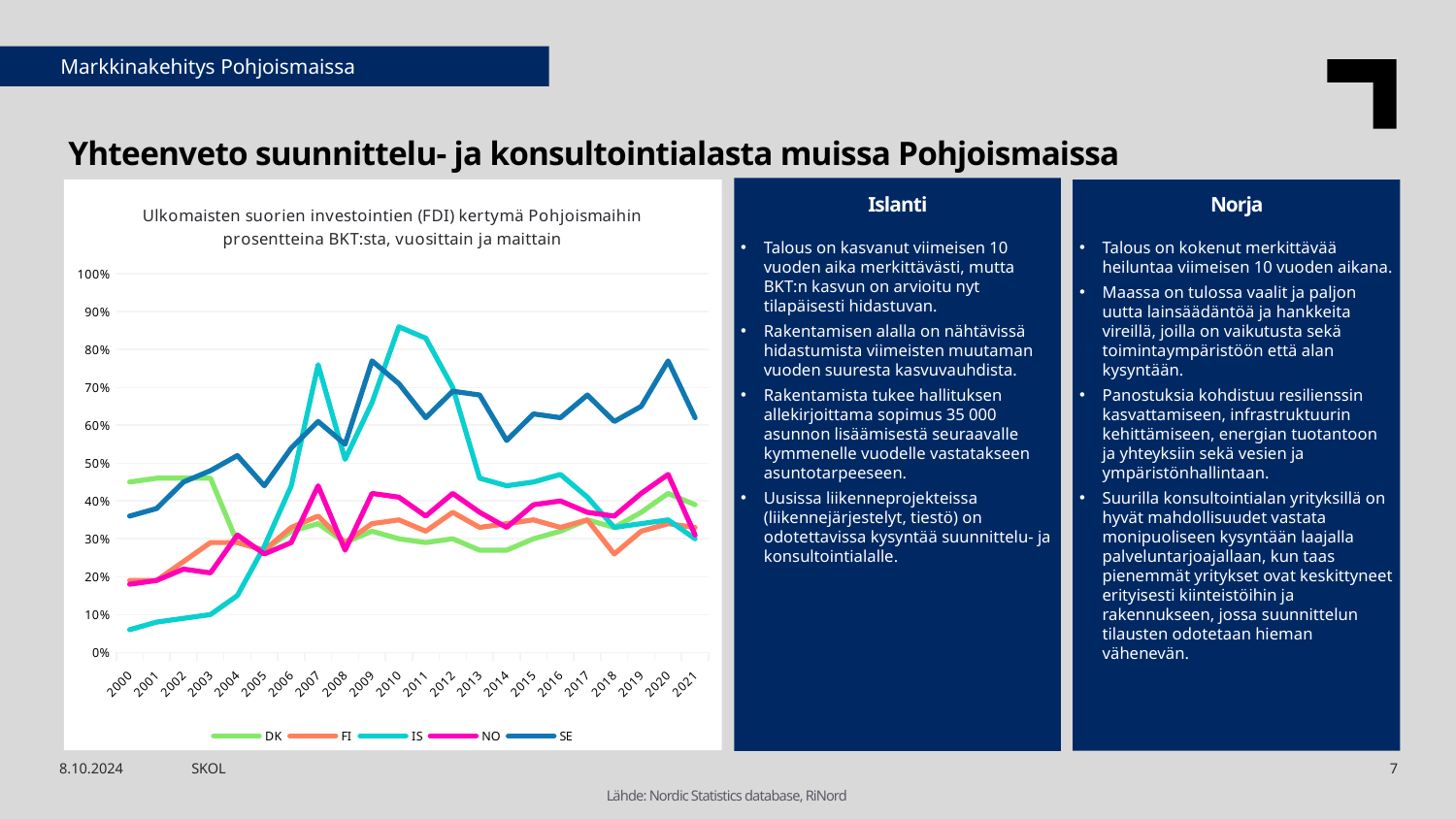
Is the value for SE in 2020 greater or less than 70%? greater Which series has the highest value in 2010? IS Which series has the highest value in 2000? DK How many years are shown on the x axis of the chart? 22 Is the value for IS in 2010 greater or less than 80%? greater What kind of chart is shown on the slide? line chart How many series does the chart legend list? 5 Does the IS series rise or fall between 2000 and 2010? rise Which series has the lowest value in 2000? IS What is the title of the chart? Ulkomaisten suorien investointien (FDI) kertymä Pohjoismaihin prosentteina BKT:sta, vuosittain ja maittain Which series are listed in the chart legend? DK, FI, IS, NO, SE Is the value for IS in 2000 greater or less than 10%? less